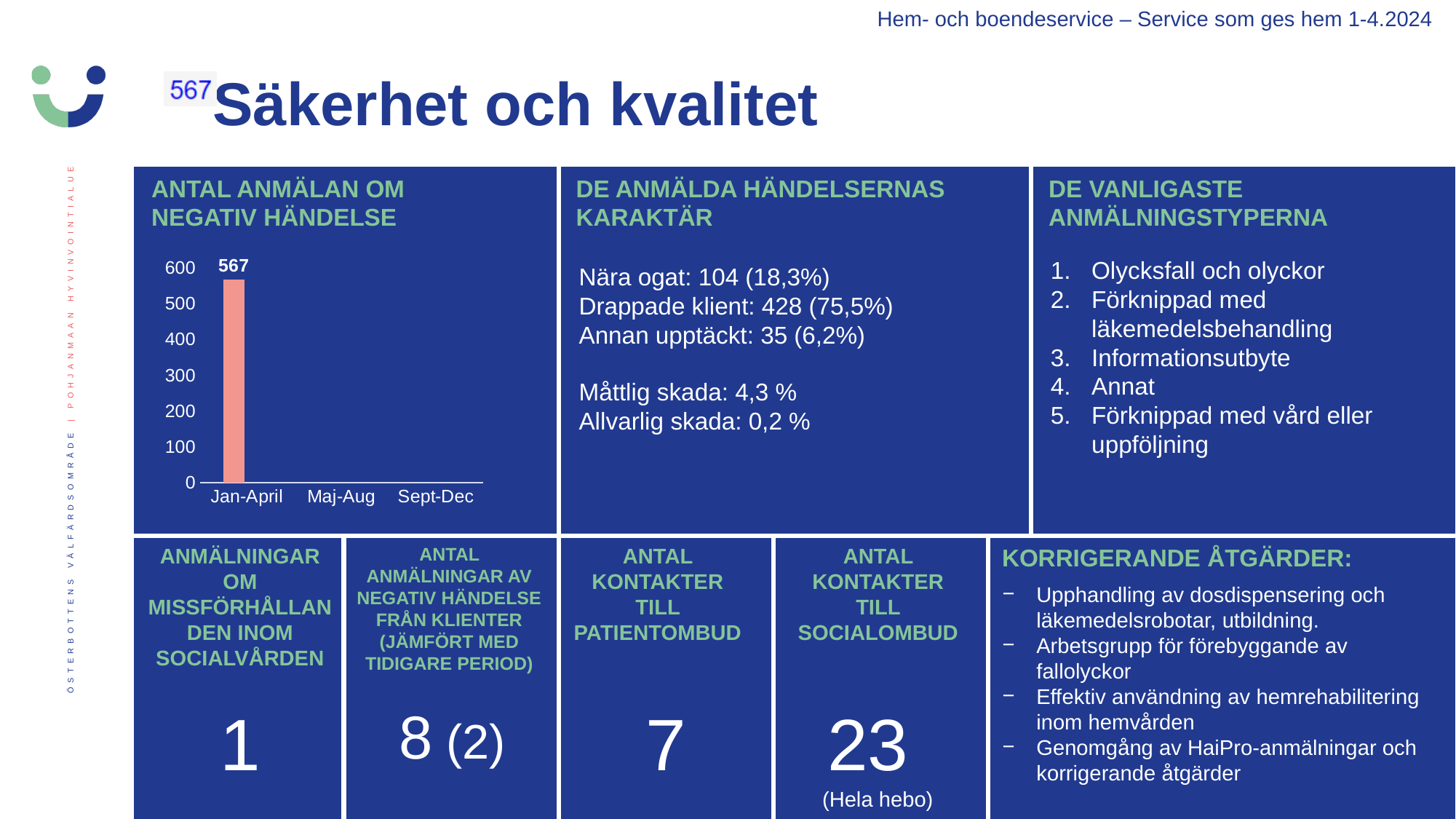
What is the label of the first category on the x axis of the chart? Jan-April How many categories are shown on the x axis of the chart "Antal anmälan om negativ händelse"? 3 What is the value for Jan-April in the chart "Antal anmälan om negativ händelse"? 567 Which category has the highest value in the chart "Antal anmälan om negativ händelse"? Jan-April Which categories in the chart "Antal anmälan om negativ händelse" have no bar plotted? Maj-Aug and Sept-Dec Is the value for Jan-April in the chart greater or less than 500? greater What kind of chart is shown under "Antal anmälan om negativ händelse"? bar chart What is the highest tick value shown on the y axis of the chart "Antal anmälan om negativ händelse"? 600 Is the value for Jan-April in the chart greater or less than 600? less What is the label of the last category on the x axis of the chart? Sept-Dec